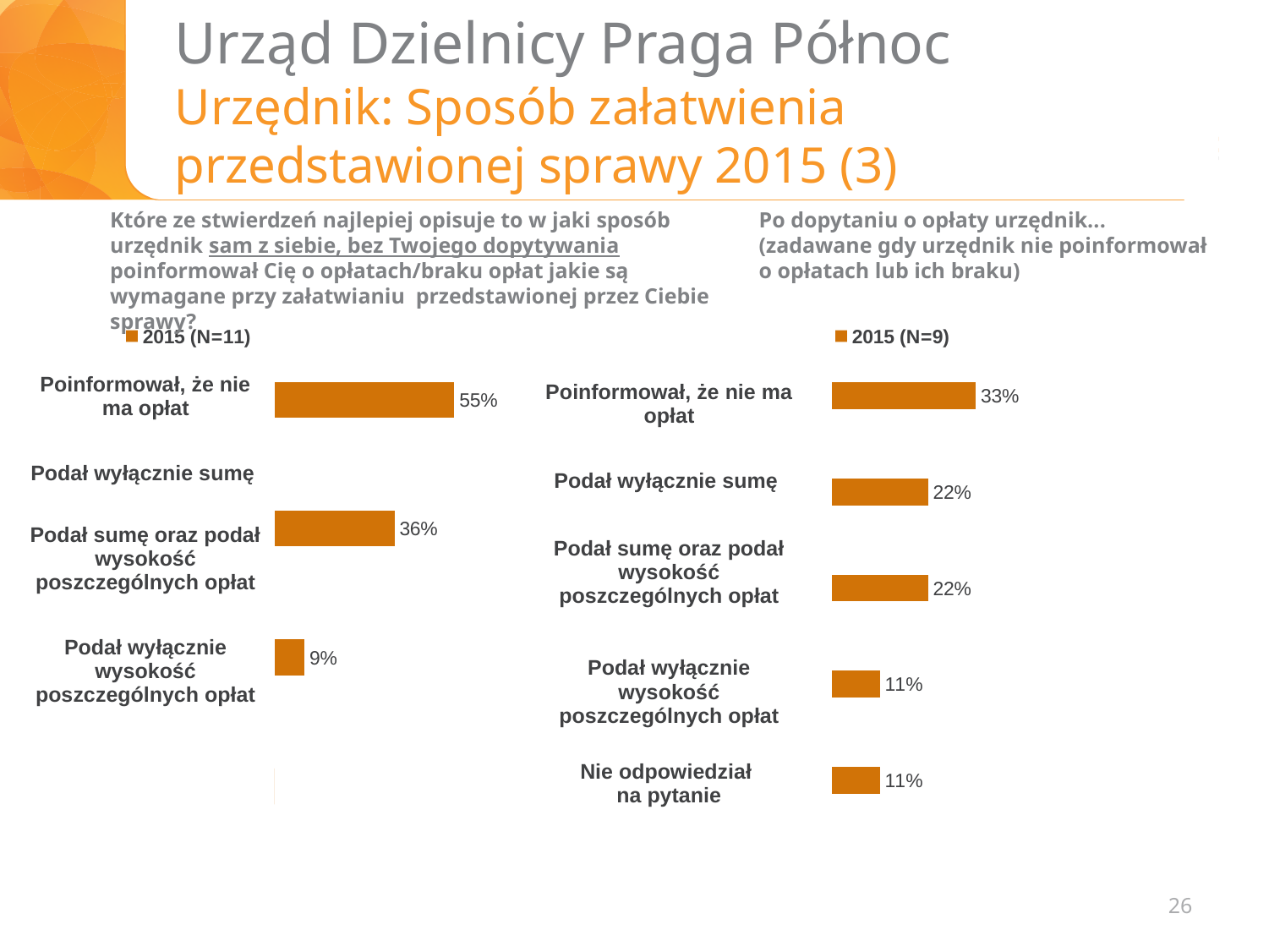
On the left chart (2015, N=11), what is the difference between the highest value (55%) and the 9% value? 46 percentage points On the right chart (2015, N=9), what is the value for "Podał wyłącznie sumę"? 22% On the left chart (2015, N=11), what is the value for "Poinformował, że nie ma opłat"? 55% On the right chart (2015, N=9), what is the value for "Poinformował, że nie ma opłat"? 33% What does the legend of the right chart say? 2015 (N=9) On the right chart (2015, N=9), which category has the highest value? Poinformował, że nie ma opłat On the right chart (2015, N=9), what is the value for "Nie odpowiedział na pytanie"? 11% On the right chart (2015, N=9), how many categories are shown? 5 What type of chart is used on the right side of the slide? Bar chart On the left chart (2015, N=11), which category has the highest value? Poinformował, że nie ma opłat On the right chart (2015, N=9), what is the difference between "Poinformował, że nie ma opłat" and "Podał wyłącznie sumę"? 11 percentage points